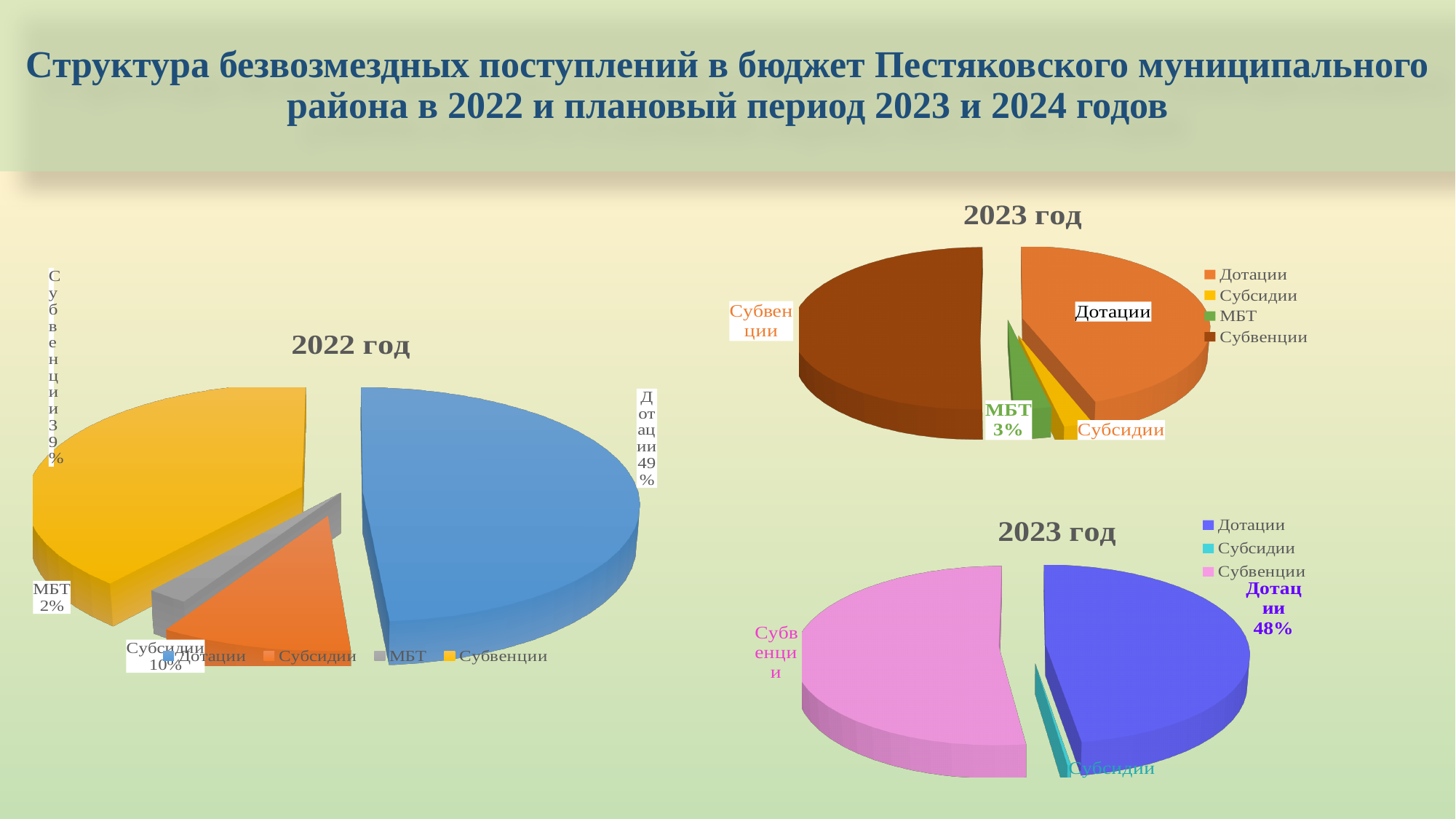
On the 2022 год chart, what share is shown for Субвенции? 39% On the top-right 2023 год chart, what share is shown for МБТ? 3% On the 2022 год chart, which category has the largest slice? Дотации What type of chart is the 2022 год chart? Pie chart On the 2022 год chart, what share is shown for Дотации? 49% On the 2022 год chart, what share is shown for МБТ? 2% On the 2022 год chart, which category has the smallest slice? МБТ On the 2022 год chart, by how many percentage points does Дотации exceed Субвенции? 10 percentage points On the bottom-right 2023 год chart, how many entries does the legend list? 3 On the top-right 2023 год chart, which is larger: Субвенции or МБТ? Субвенции On the bottom-right 2023 год chart, what share is shown for Дотации? 48% On the 2022 год chart, how many slices does the pie have? 4